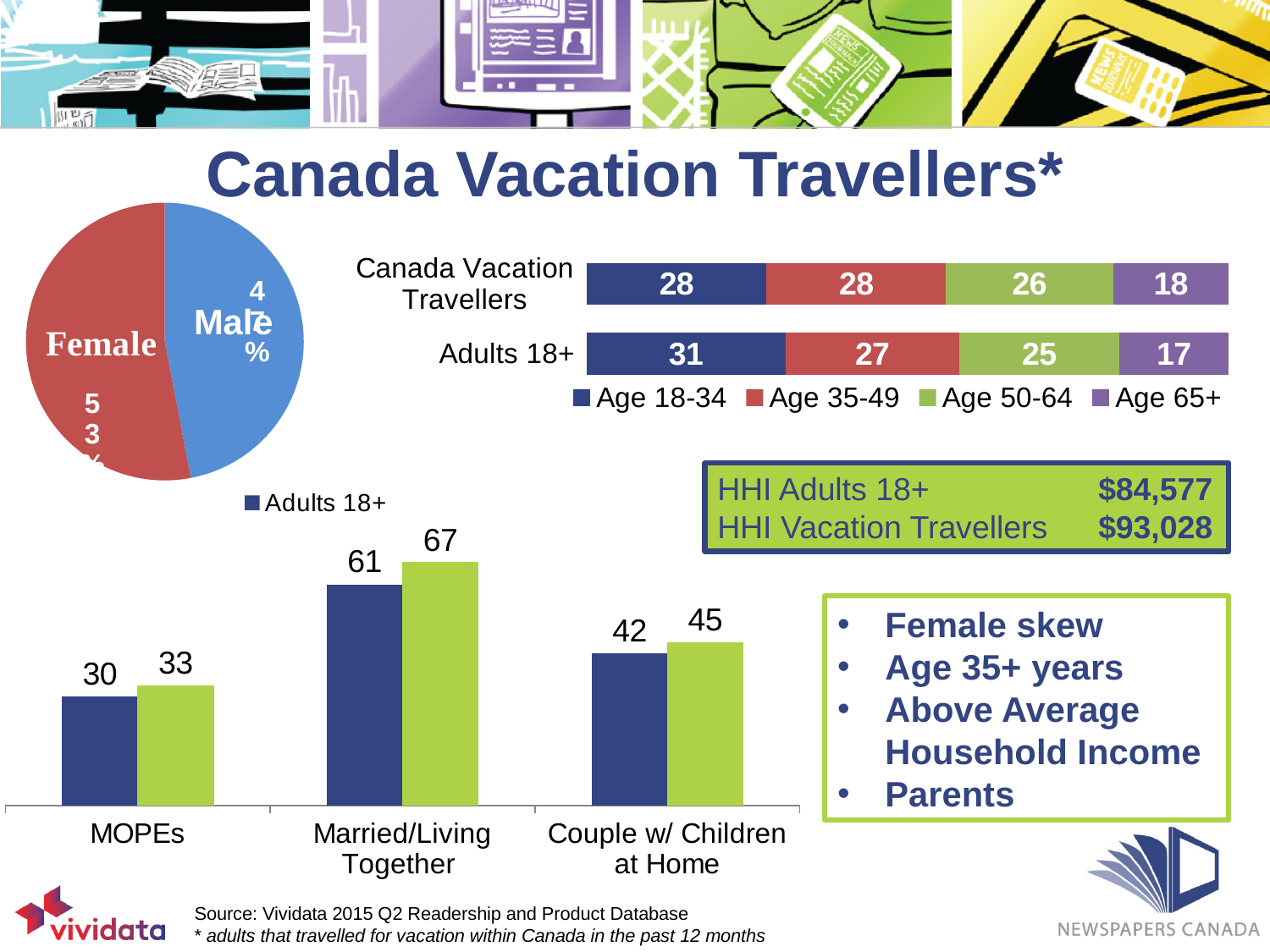
In the grouped bar chart at the bottom left, what is the Adults 18+ value for MOPEs? 30 In the stacked bar chart, what is the value for Age 65+ among Adults 18+? 17 In the grouped bar chart at the bottom left, what is the Adults 18+ value for Married/Living Together? 61 In the stacked bar chart, what is the value for Age 18-34 among Canada Vacation Travellers? 28 In the grouped bar chart at the bottom left, which category has the highest values? Married/Living Together In the stacked bar chart, how many series does the legend list? 4 In the stacked bar chart, what is the difference between the Age 18-34 values for Adults 18+ and Canada Vacation Travellers? 3 In the stacked bar chart, which age group has the smallest value for Canada Vacation Travellers? Age 65+ In the stacked bar chart, which is larger: the Age 50-64 value for Canada Vacation Travellers or for Adults 18+? Canada Vacation Travellers In the stacked bar chart, what is the total of the Canada Vacation Travellers bar? 100 In the pie chart, which slice is larger, Female or Male? Female In the grouped bar chart at the bottom left, how many categories are shown on the x axis? 3